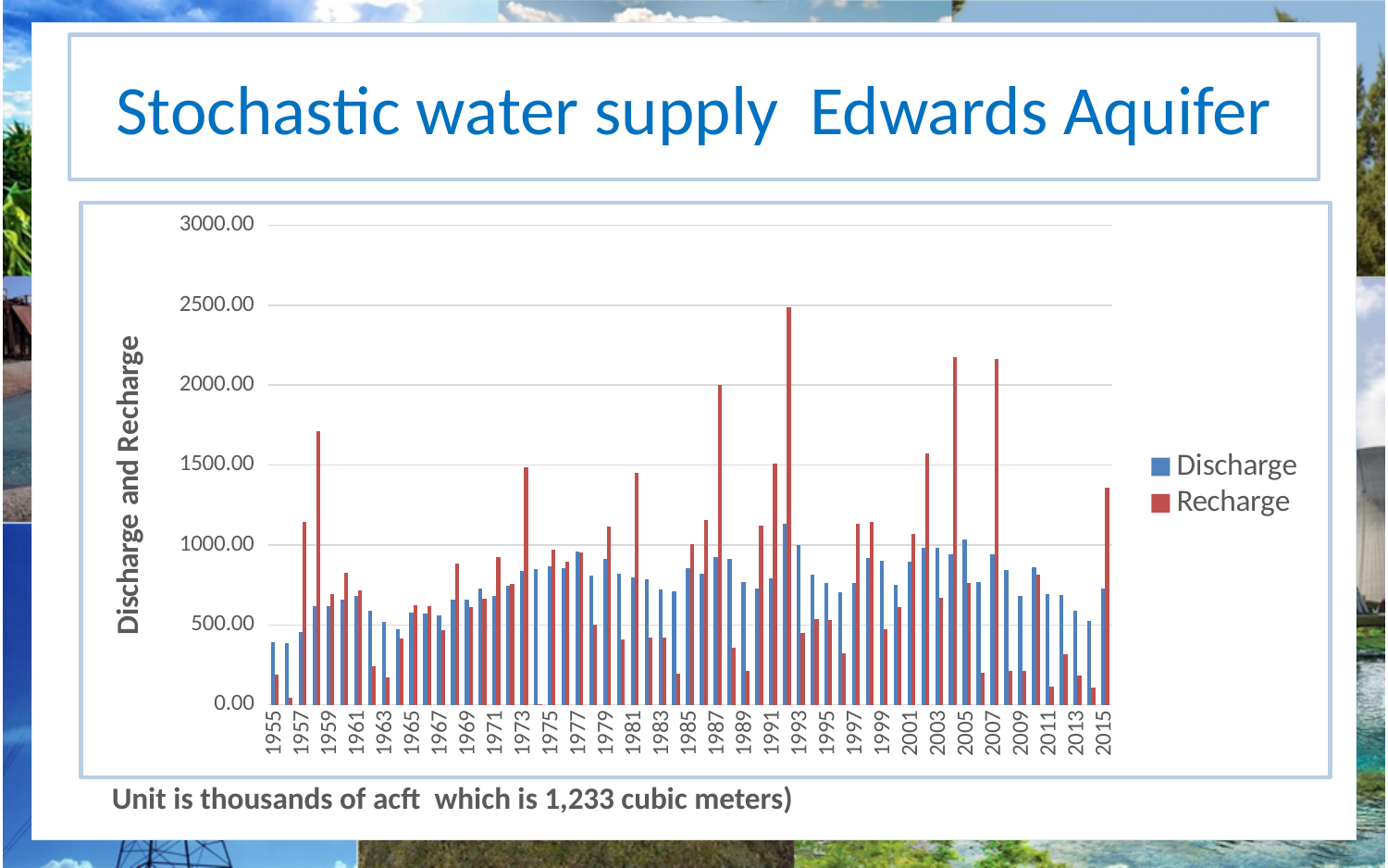
What are the two series named in the legend? Discharge and Recharge Is the Recharge value for 1958 greater or less than 1500? greater What is the title of the vertical axis? Discharge and Recharge Is the Recharge value for 2015 greater or less than 1000? greater In 1955, which is larger, Discharge or Recharge? Discharge Is the Discharge value for 1955 greater or less than 500? less In 1992, which is larger, Discharge or Recharge? Recharge In which year is the Recharge value highest? 1992 What kind of chart is shown on the slide? Bar chart How many series does the legend list? 2